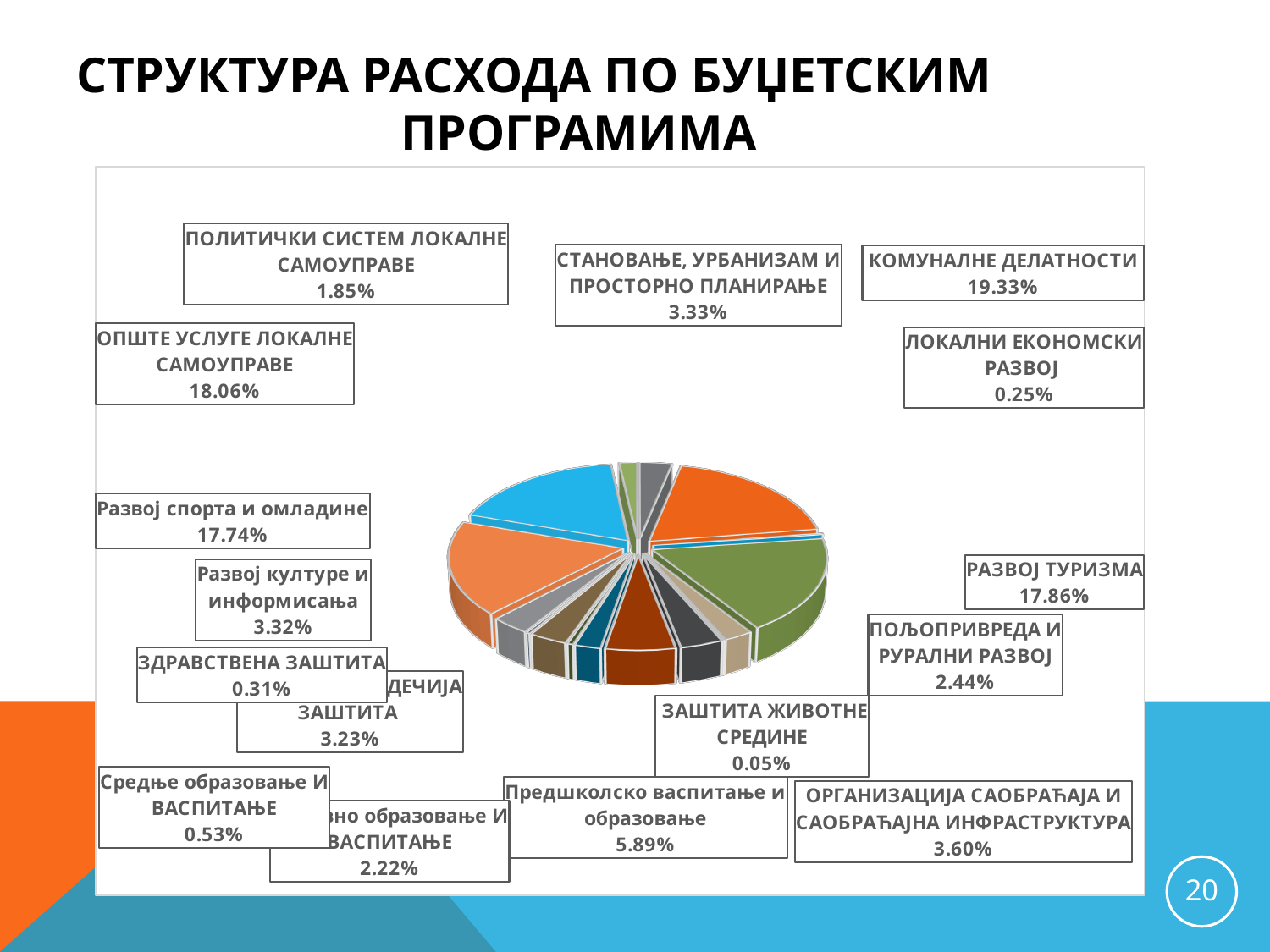
What is the value for ОПШТЕ УСЛУГЕ ЛОКАЛНЕ САМОУПРАВЕ? 18.06% What type of chart is shown on the slide? Pie chart Which has a larger share: ПОЉОПРИВРЕДА И РУРАЛНИ РАЗВОЈ or ЛОКАЛНИ ЕКОНОМСКИ РАЗВОЈ? ПОЉОПРИВРЕДА И РУРАЛНИ РАЗВОЈ What is the difference in percentage points between КОМУНАЛНЕ ДЕЛАТНОСТИ and ОПШТЕ УСЛУГЕ ЛОКАЛНЕ САМОУПРАВЕ? 1.27 percentage points Which budget program has the smallest share in the pie chart? ЗАШТИТА ЖИВОТНЕ СРЕДИНЕ What percentage is shown for Предшколско васпитање и образовање? 5.89% What is the value shown for РАЗВОЈ ТУРИЗМА? 17.86% What is the title of the slide containing the pie chart? СТРУКТУРА РАСХОДА ПО БУЏЕТСКИМ ПРОГРАМИМА Which budget program has the largest share in the pie chart? КОМУНАЛНЕ ДЕЛАТНОСТИ What share of expenditure goes to КОМУНАЛНЕ ДЕЛАТНОСТИ? 19.33% How many budget program categories are labeled on the pie chart? 16 Which has a larger share: Развој спорта и омладине or РАЗВОЈ ТУРИЗМА? РАЗВОЈ ТУРИЗМА